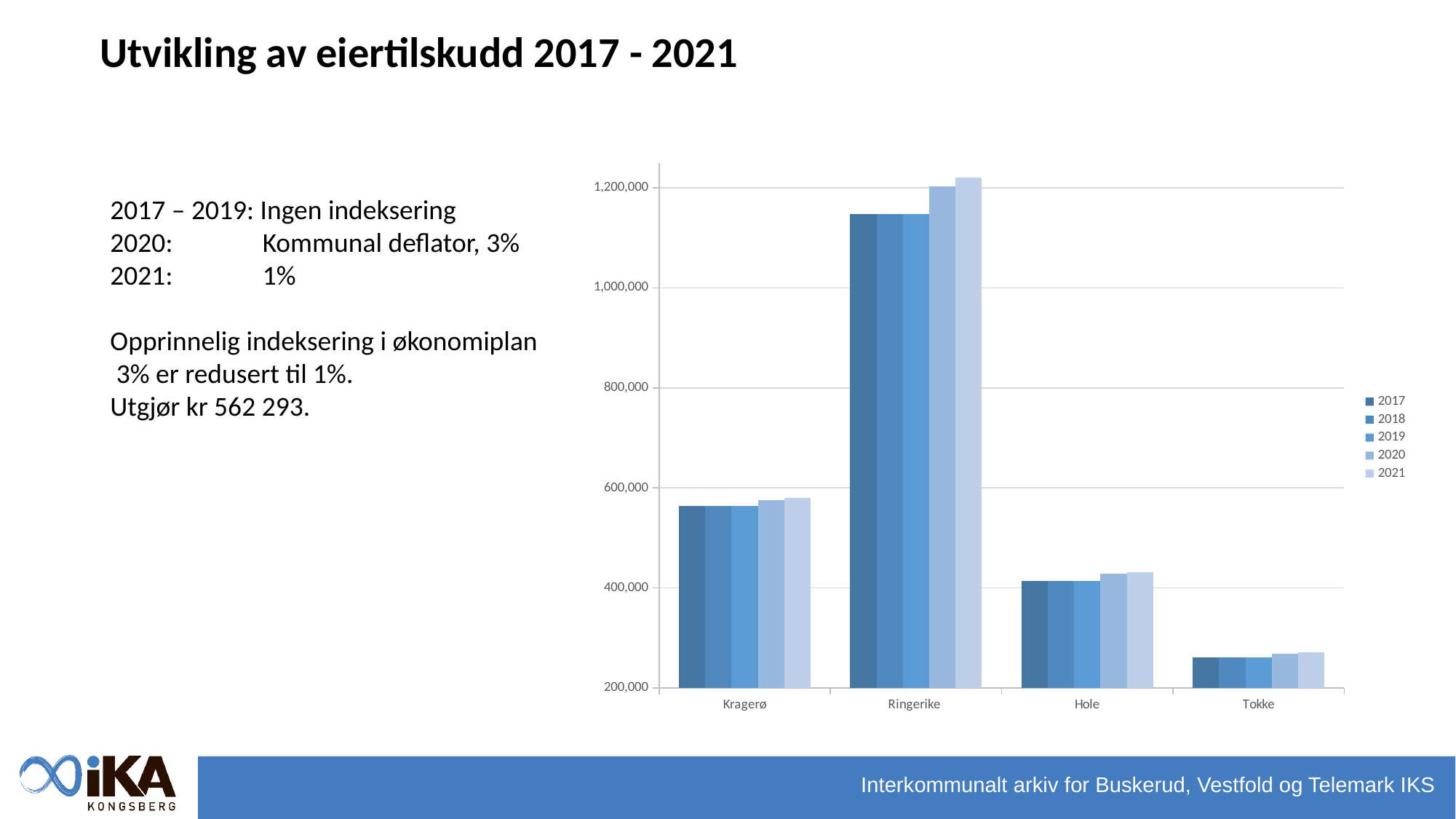
Is the value for Ringerike in 2017 greater or less than 1,000,000? greater Which municipality has the highest values in the chart? Ringerike Is the value for Hole in 2021 greater or less than 400,000? greater Which municipality has the lowest values in the chart? Tokke Which years are listed in the chart's legend? 2017, 2018, 2019, 2020, 2021 Is the value for Kragerø in 2017 greater or less than 600,000? less Do the values for Ringerike rise or fall from 2019 to 2021? rise How many categories (municipalities) are shown on the x axis of the chart? 4 How many series does the chart's legend list? 5 Which has the larger value for 2017, Kragerø or Hole? Kragerø What kind of chart is shown on the slide? bar chart